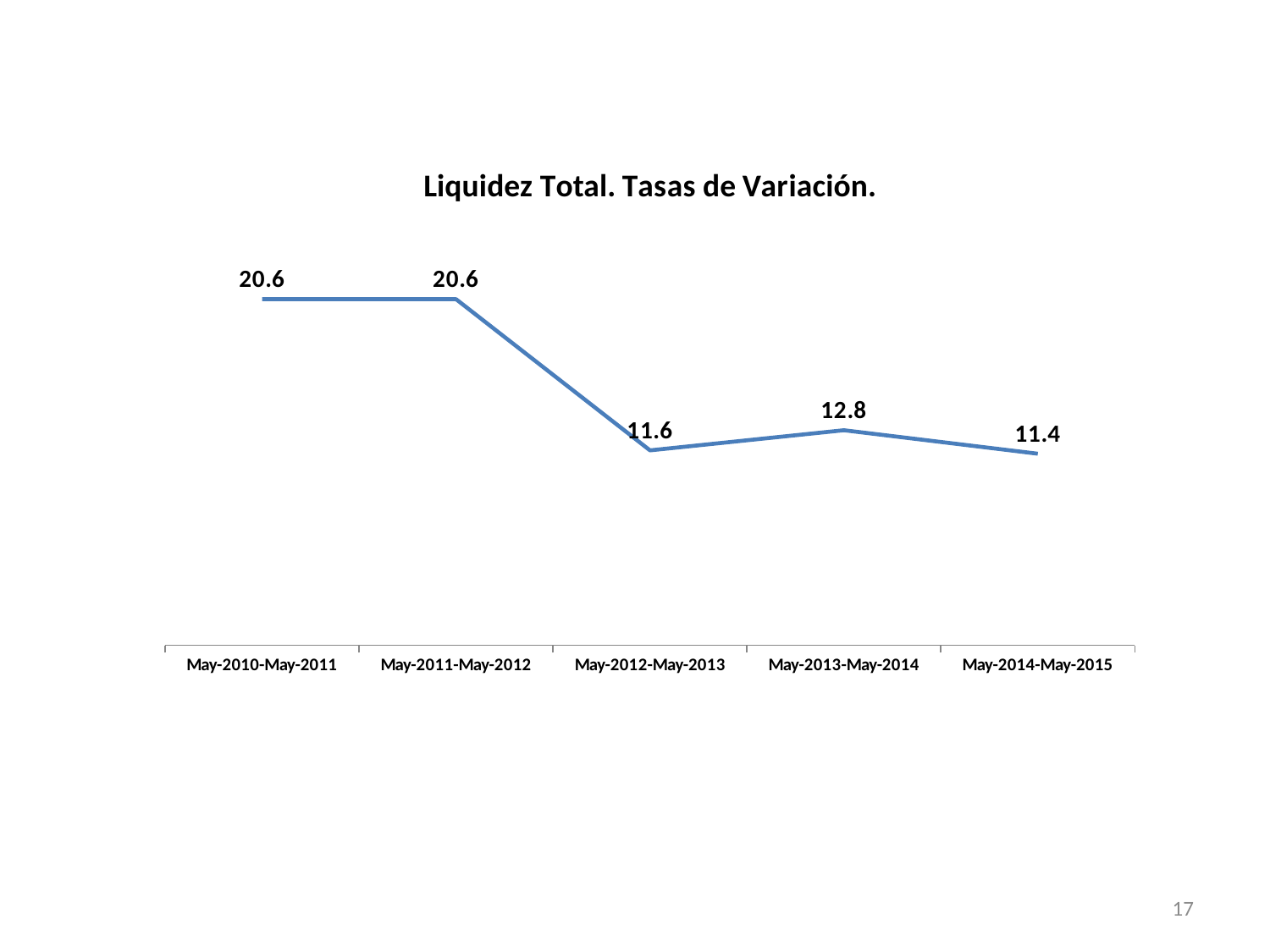
What kind of chart is shown? Line chart What is the value for May-2013-May-2014? 12.8 What is the value for May-2010-May-2011? 20.6 What is the value for May-2012-May-2013? 11.6 What is the title of the chart? Liquidez Total. Tasas de Variación. What is the value for May-2014-May-2015? 11.4 What is the difference between the values for May-2013-May-2014 and May-2014-May-2015? 1.4 Which period has the lowest value? May-2014-May-2015 How many periods are plotted on the x axis? 5 Do the values generally rise or fall from May-2010-May-2011 to May-2014-May-2015? Fall Which is larger, the value for May-2012-May-2013 or the value for May-2013-May-2014? May-2013-May-2014 What is the difference between the values for May-2011-May-2012 and May-2012-May-2013? 9.0